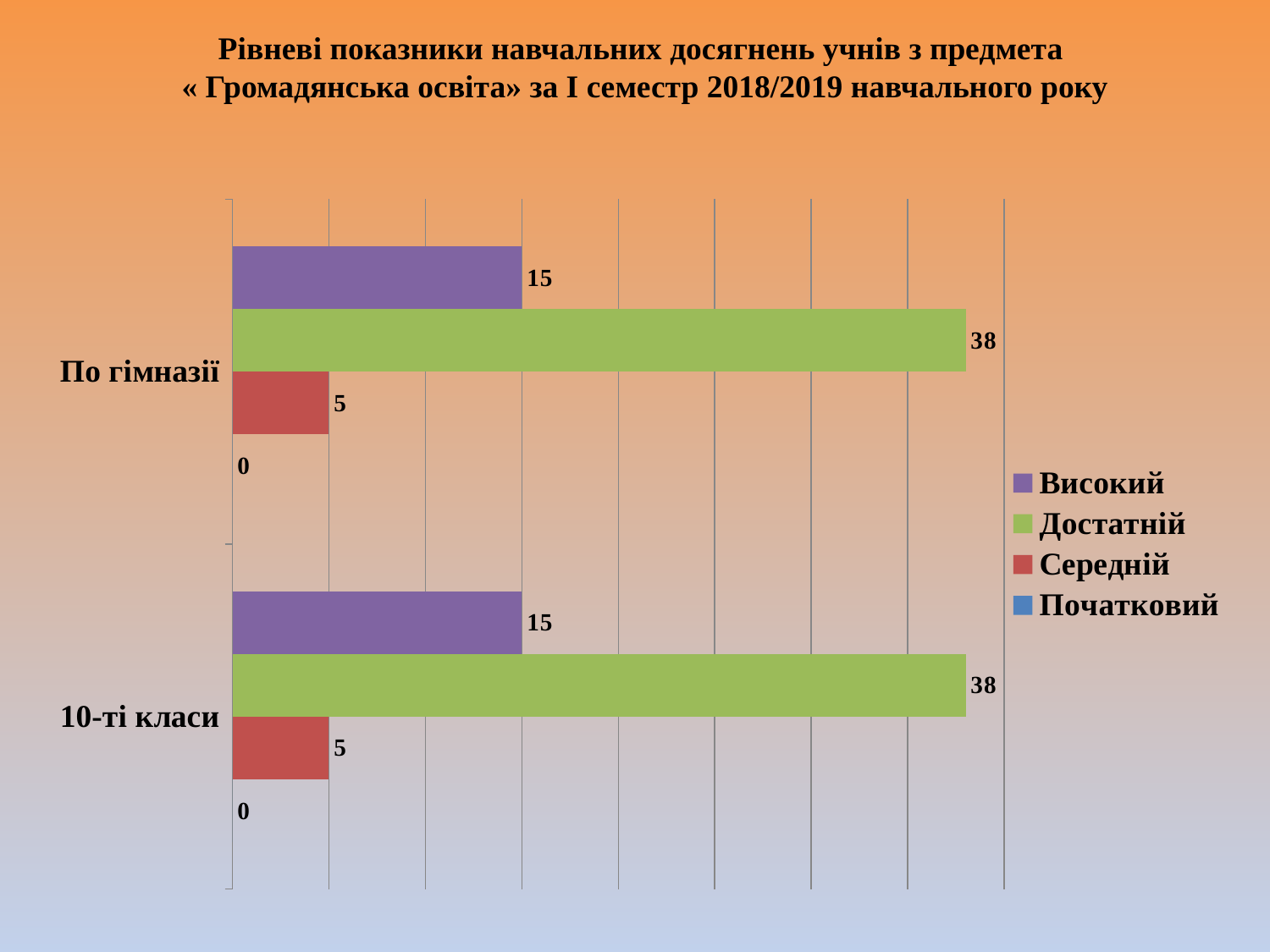
What is the value for Достатній in the category По гімназії? 38 What kind of chart is shown on the slide? bar chart Which series has the lowest value in the category По гімназії? Початковий What is the value for Початковий in the category 10-ті класи? 0 Which legend entry is shown in green? Достатній What is the value for Високий in the category 10-ті класи? 15 Which is larger in the category 10-ті класи: Високий or Середній? Високий What is the difference between the Достатній and Високий values in the category По гімназії? 23 How many series does the legend list? 4 Which series has the highest value in the category 10-ті класи? Достатній What is the value for Середній in the category По гімназії? 5 How many categories are shown on the vertical axis? 2